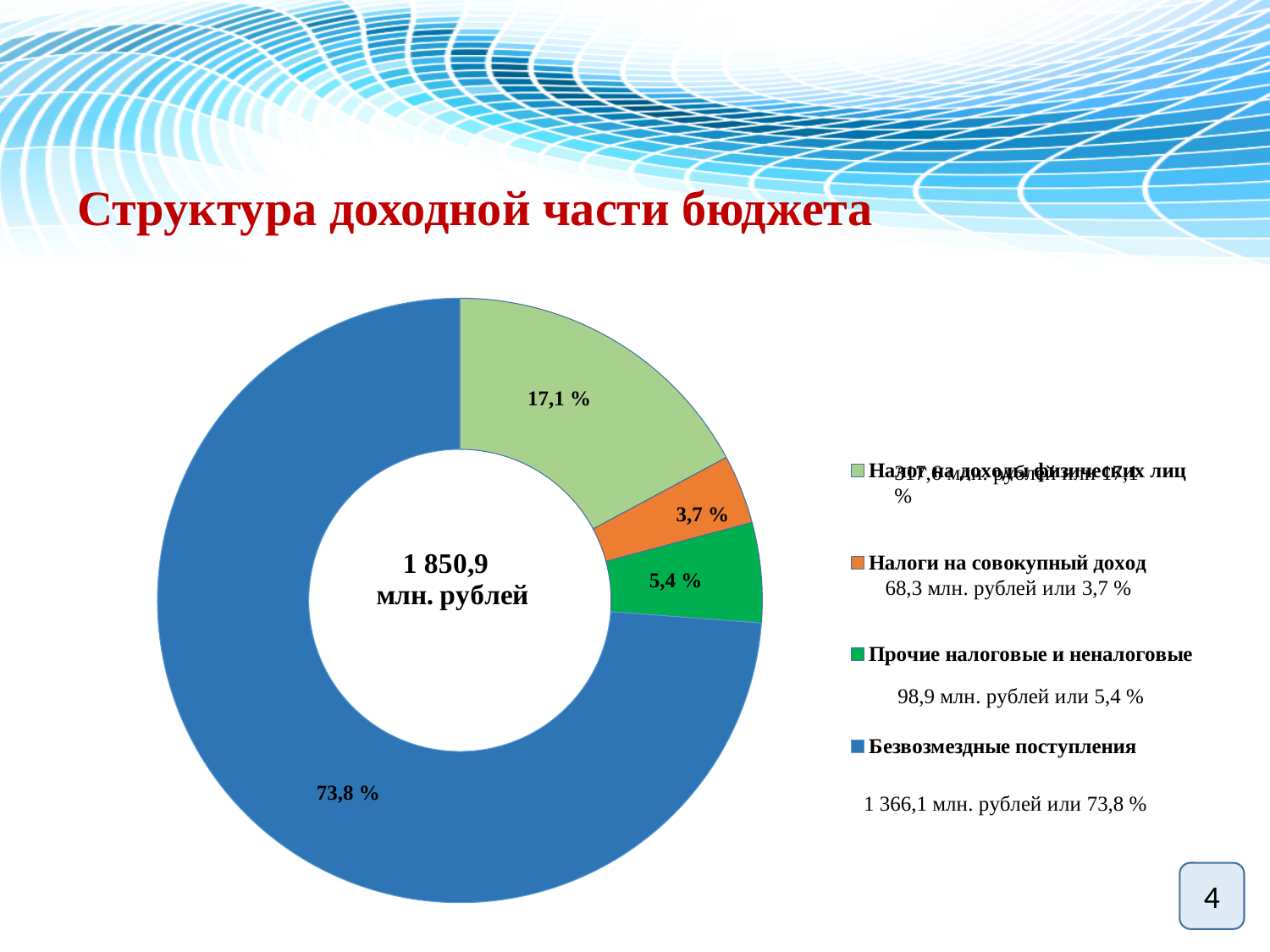
What share of the chart is Налоги на совокупный доход? 3,7 % What share of the chart is Безвозмездные поступления? 73,8 % What kind of chart is shown on the slide? doughnut (pie) chart What total value is shown in the centre of the doughnut chart? 1 850,9 млн. рублей What is the title of the chart on the slide? Структура доходной части бюджета What share of the chart is Налог на доходы физических лиц? 17,1 % Which category has the smallest share of the chart? Налоги на совокупный доход Which is larger: the share of Прочие налоговые и неналоговые or the share of Налоги на совокупный доход? Прочие налоговые и неналоговые Which category has the largest share of the chart? Безвозмездные поступления How many slices does the doughnut chart have? 4 How many entries does the legend list? 4